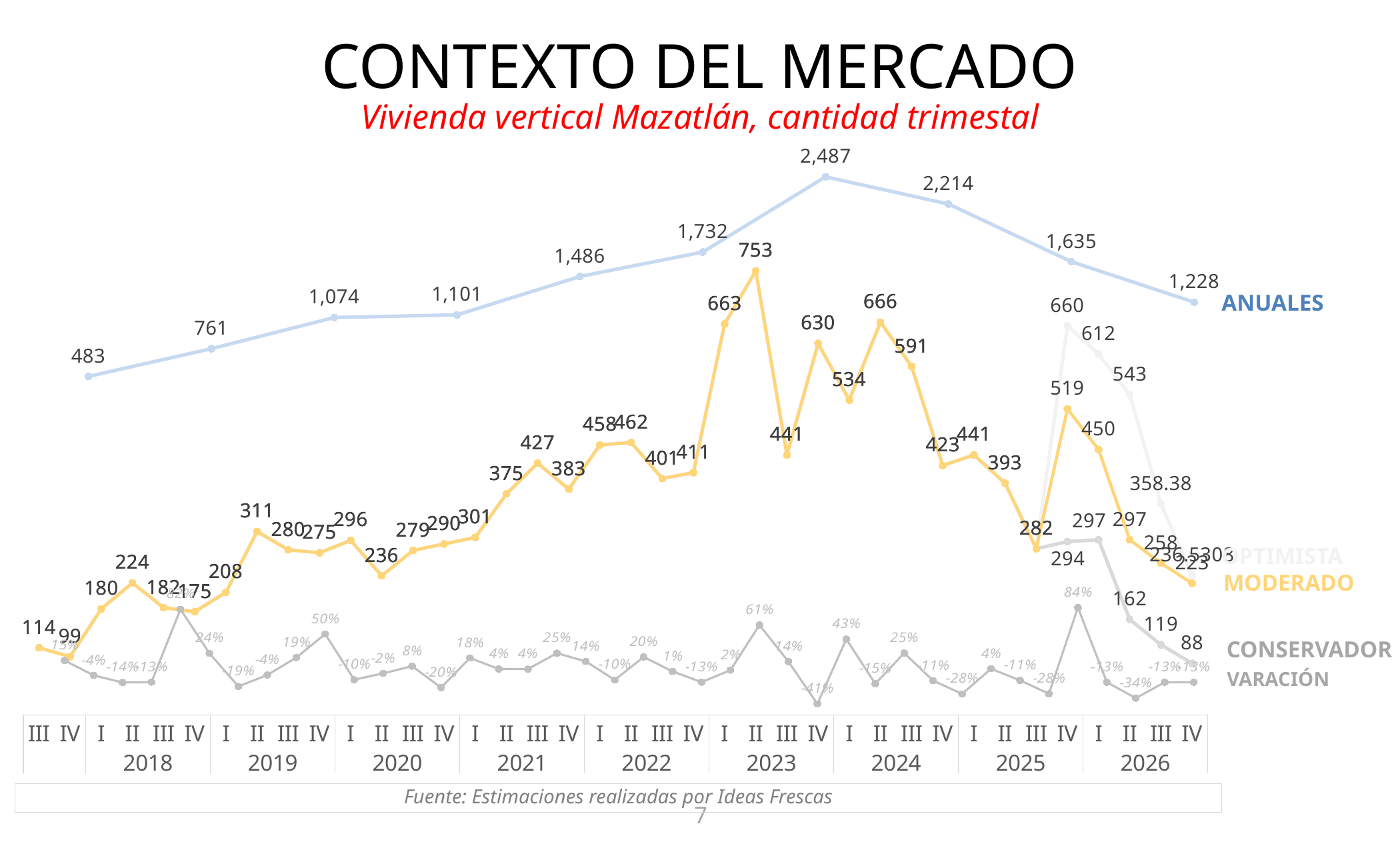
What is the highest value on the ANUALES line? 2,487 What kind of chart is shown on the slide? line chart Does the ANUALES line rise or fall from 2023 to 2026? fall Which year has the larger ANUALES value, 2021 or 2022? 2022 What is the ANUALES value for 2019? 1,074 What is the MODERADO value for quarter IV of 2026? 223 What is the ANUALES value for 2024? 2,214 What is the lowest value on the ANUALES line? 483 What is the CONSERVADOR value for quarter IV of 2026? 88 What is the difference between the ANUALES values for 2025 and 2026? 407 What is the highest quarterly value on the MODERADO line? 753 What is the difference between the ANUALES values for 2023 and 2024? 273